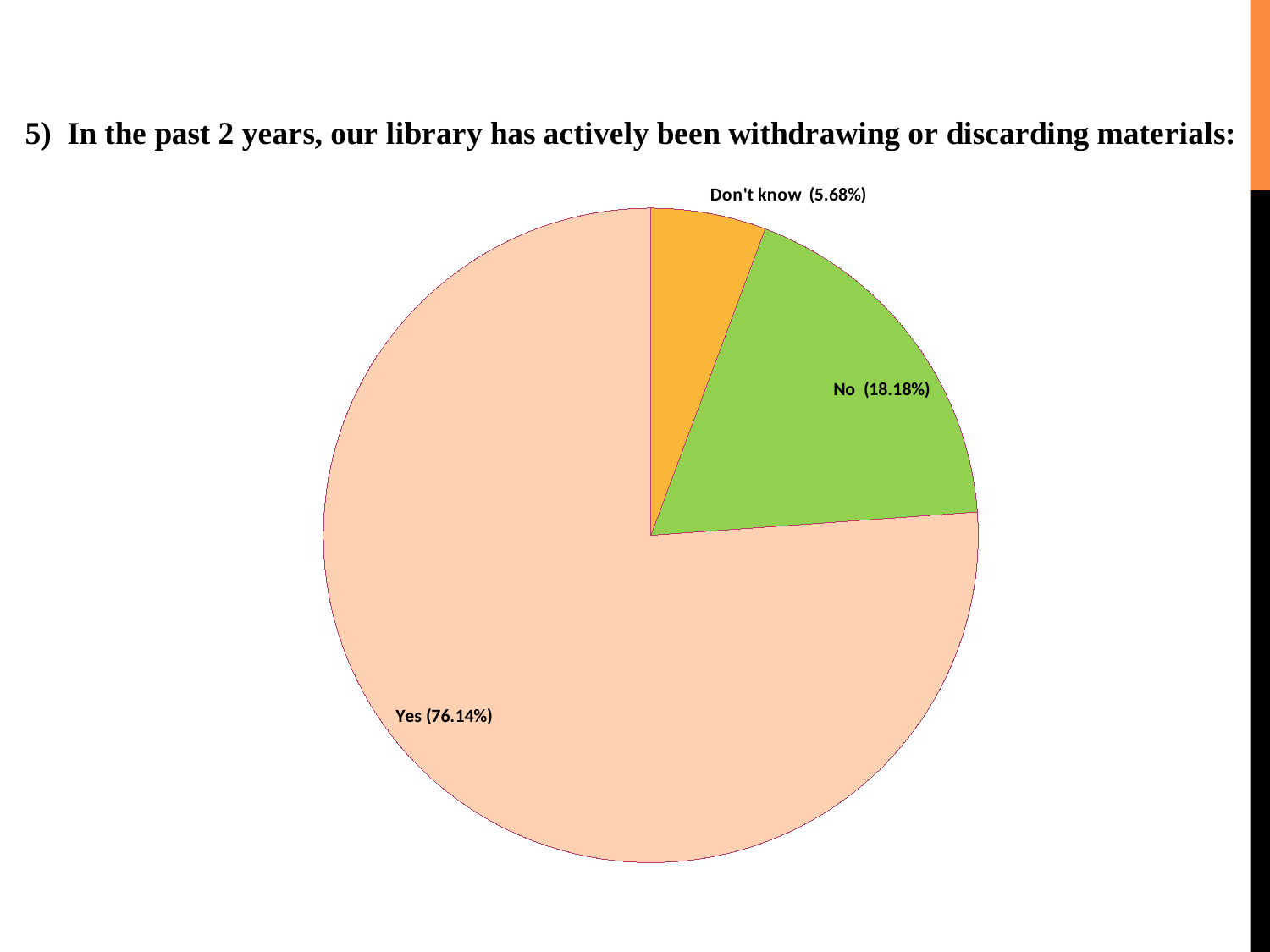
What kind of chart is shown on the slide? pie chart Which response has the smallest share of the pie? Don't know What is the difference in percentage points between the "No" and "Don't know" shares? 12.5 Which is larger, the share for "No" or the share for "Don't know"? No What question does the chart title say the responses are about? In the past 2 years, our library has actively been withdrawing or discarding materials What percentage of respondents answered "Yes"? 76.14% What percentage of respondents answered "No"? 18.18% How many slices does the pie chart have? 3 Which response has the largest share of the pie? Yes What colour is the "No" slice? green What percentage of respondents answered "Don't know"? 5.68% What is the difference in percentage points between the "Yes" and "No" shares? 57.96